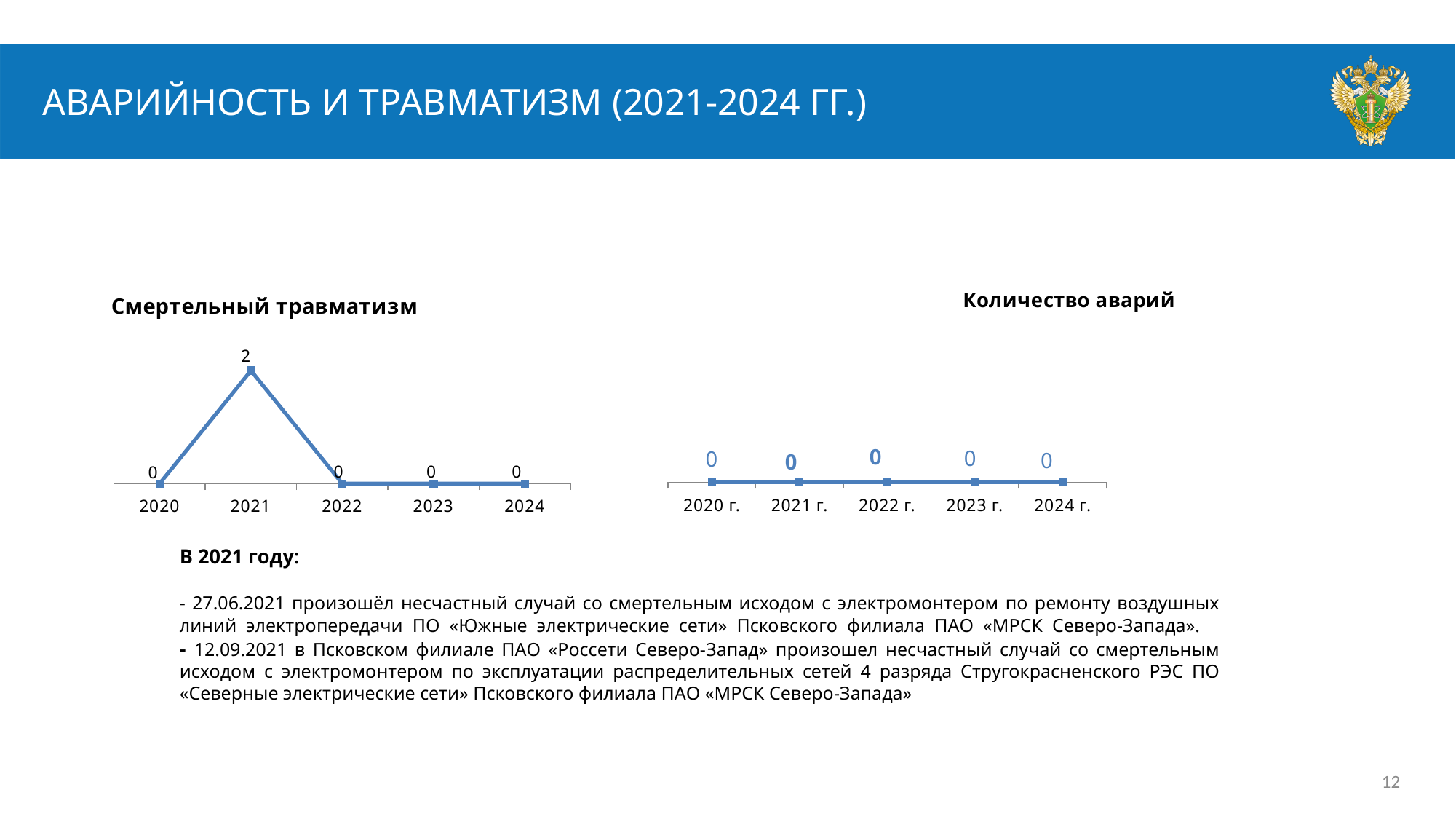
На графике «Количество аварий» как меняются значения с 2020 г. по 2024 г.? не меняются, все равны 0 На графике «Количество аварий» какое значение указано для 2022 г.? 0 На графике «Смертельный травматизм» какое значение больше: за 2021 или за 2024 год? 2021 На графике «Смертельный травматизм» какое значение указано для 2021 года? 2 На графике «Смертельный травматизм» в каком году значение наибольшее? 2021 Как называется график, расположенный справа на слайде? Количество аварий На графике «Смертельный травматизм» как меняется значение с 2021 по 2022 год? падает На графике «Смертельный травматизм» какое значение указано для 2023 года? 0 Какого типа график «Смертельный травматизм»? линейный график Сколько точек (лет) показано на графике «Смертельный травматизм»? 5 На графике «Смертельный травматизм» на сколько значение 2021 года больше значения 2022 года? 2 Сколько точек (лет) показано на графике «Количество аварий»? 5